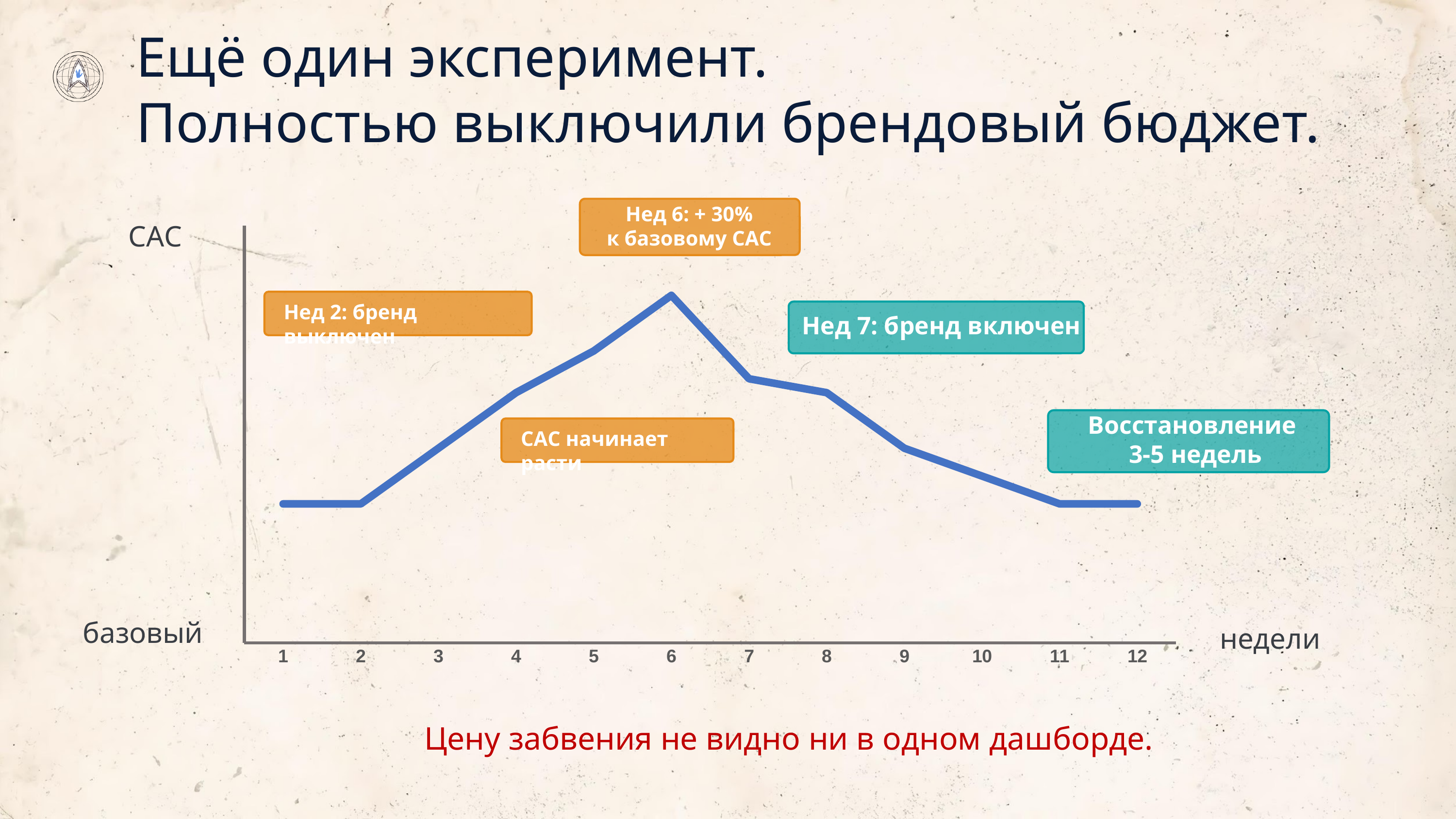
Does the CAC line rise or fall between week 6 and week 11? fall What kind of chart is shown on the slide? line chart How many weeks are marked on the x axis of the chart? 12 According to the annotation, how much higher than the base CAC is the value at week 6? + 30% At which week does the CAC line reach its highest point? 6 Which week has the higher CAC value, week 6 or week 8? 6 Which week has the higher CAC value, week 5 or week 9? 5 According to the annotation, at which week was the brand budget turned back on? 7 Does the CAC line rise or fall between week 2 and week 6? rise Does the CAC line rise or fall between week 1 and week 2? neither, it stays flat What label is shown on the x axis of the chart? недели